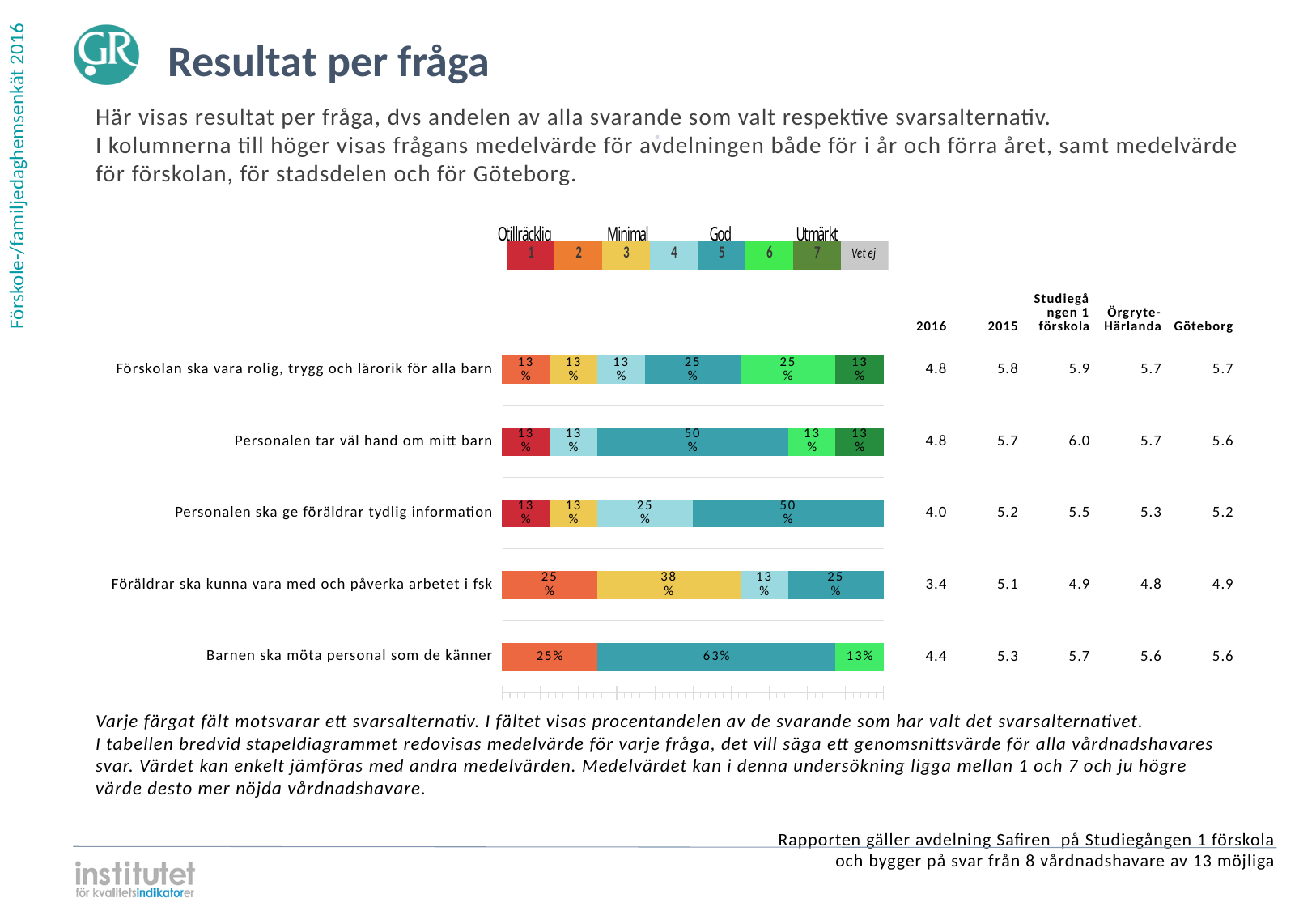
What is the difference between the 2015 and 2016 mean values for "Personalen ska ge föräldrar tydlig information"? 1.2 What kind of chart is used to show the results per question? Stacked bar chart What is the Göteborg mean value for "Personalen ska ge föräldrar tydlig information"? 5.2 Which question has the largest single segment in its bar? Barnen ska möta personal som de känner Is the 2016 mean value for "Förskolan ska vara rolig, trygg och lärorik för alla barn" larger or smaller than its 2015 value? Smaller What percentage chose answer option 3 (yellow) for "Föräldrar ska kunna vara med och påverka arbetet i fsk"? 38% What is the 2016 mean value for "Föräldrar ska kunna vara med och påverka arbetet i fsk"? 3.4 What percentage chose answer option 5 (teal) for "Personalen tar väl hand om mitt barn"? 50% What percentage of respondents chose answer option 5 (teal) for "Barnen ska möta personal som de känner"? 63% How many questions (categories) are shown in the bar chart? 5 Which question has the lowest 2016 mean value? Föräldrar ska kunna vara med och påverka arbetet i fsk